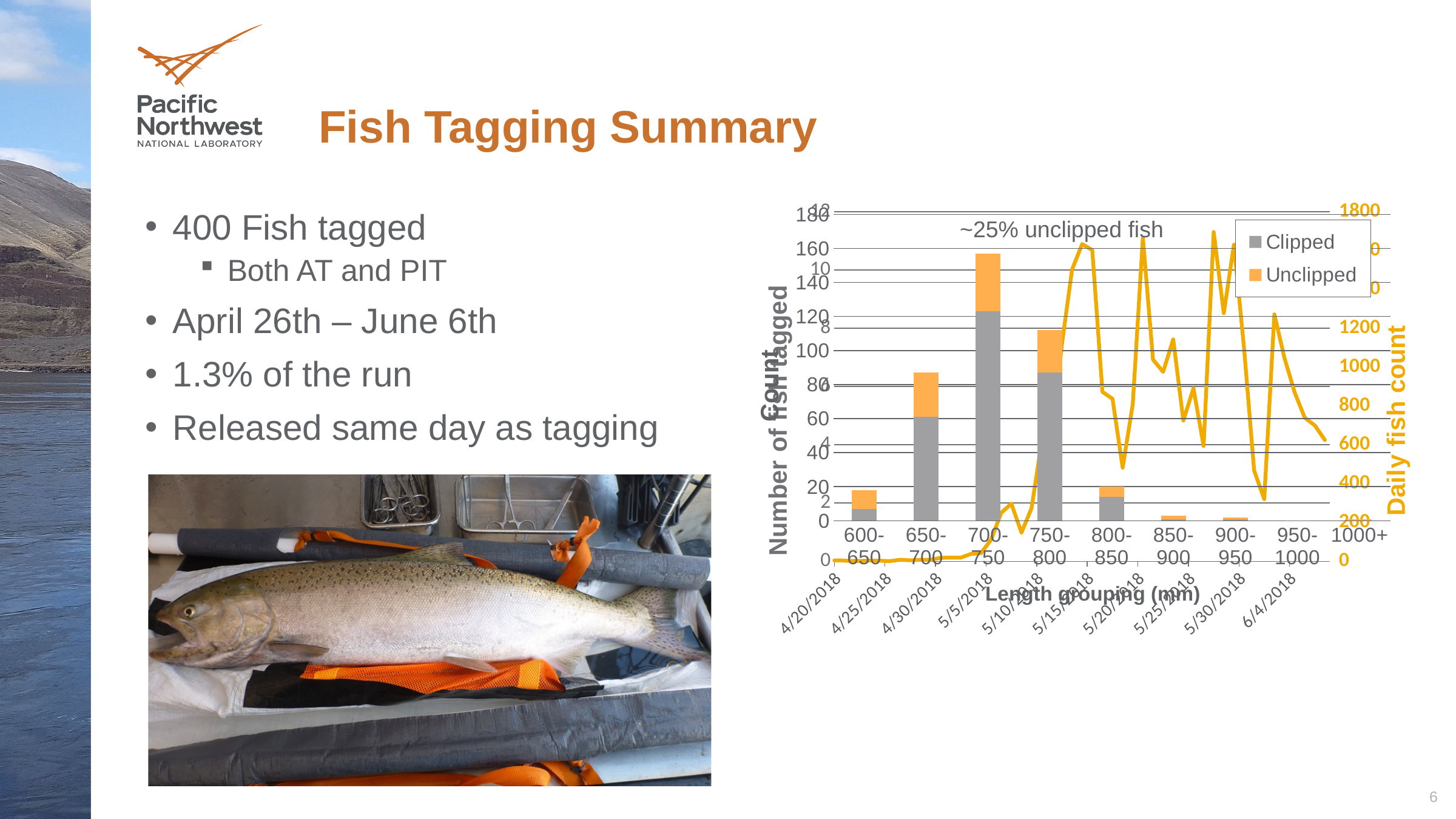
What are the two series named in the legend of the stacked bar chart? Clipped and Unclipped How many series does the legend of the stacked bar chart list? 2 Is the total number of fish tagged for the 650-700 length grouping greater or less than 100? less Is the total number of fish tagged for the 600-650 length grouping greater or less than 40? less Is the total number of fish tagged for the 700-750 length grouping greater or less than 140? greater What kind of chart shows the number of fish tagged by length grouping? Stacked bar chart What is the title of the right-hand vertical axis used by the line chart? Daily fish count In the stacked bar chart, which has more fish tagged: the 650-700 grouping or the 750-800 grouping? 750-800 How many length groupings are shown on the x axis of the stacked bar chart? 9 What kind of chart shows the daily fish count over dates from 4/20/2018 to 6/4/2018? Line chart In the stacked bar chart, which length grouping has the highest number of fish tagged? 700-750